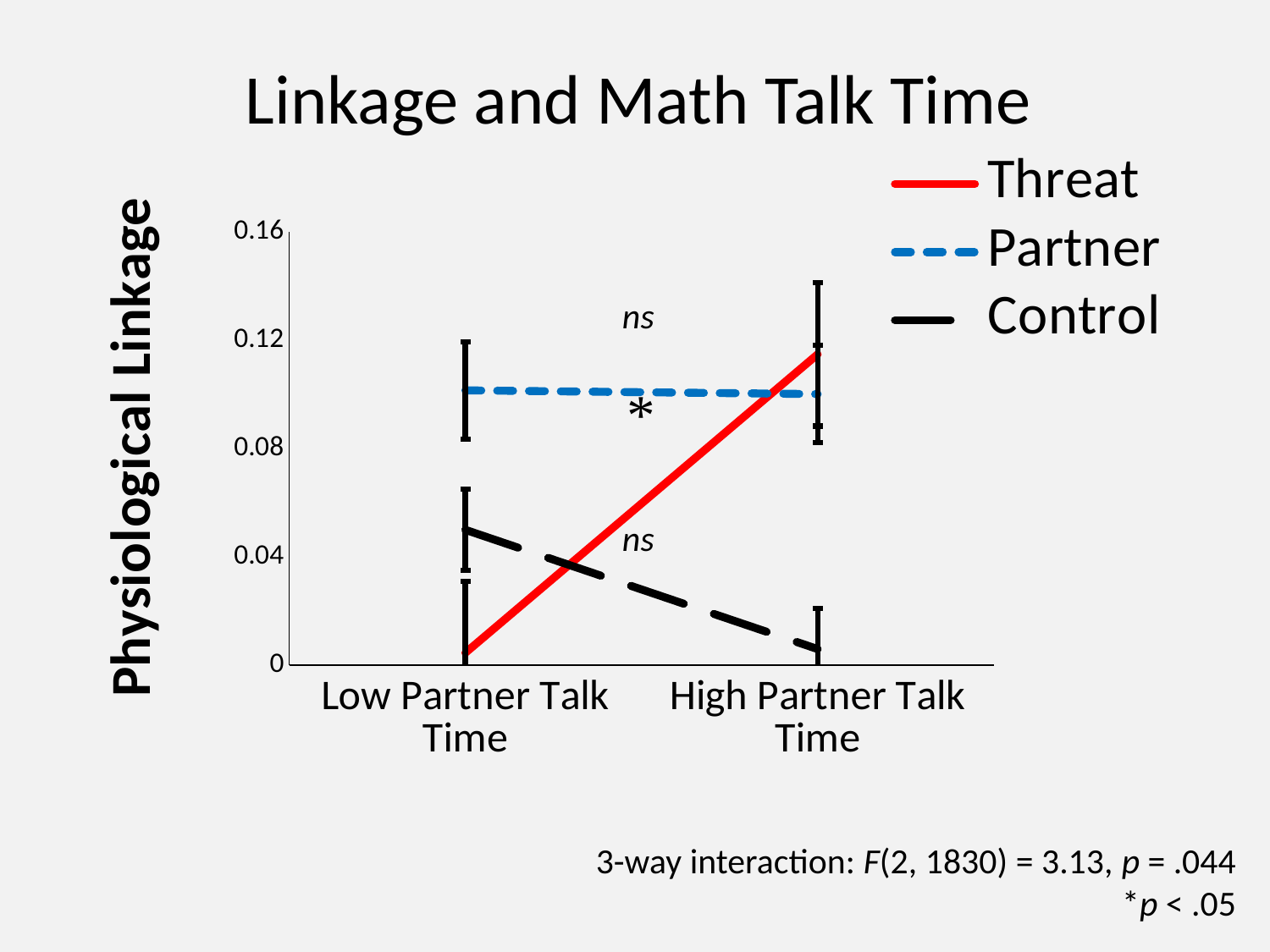
What is the label on the y axis? Physiological Linkage Is the value for Threat at Low Partner Talk Time greater or less than 0.04? less How many series does the legend list? 3 Is the value for Control at High Partner Talk Time greater or less than 0.04? less Which series has the highest value at High Partner Talk Time? Threat What kind of chart is shown on the slide? line chart How many categories are on the x axis? 2 Does the Control series rise or fall from Low Partner Talk Time to High Partner Talk Time? fall At Low Partner Talk Time, which is larger, Partner or Threat? Partner Does the Threat series rise or fall from Low Partner Talk Time to High Partner Talk Time? rise Is the value for Threat at High Partner Talk Time greater or less than 0.08? greater What is the title of the chart? Linkage and Math Talk Time